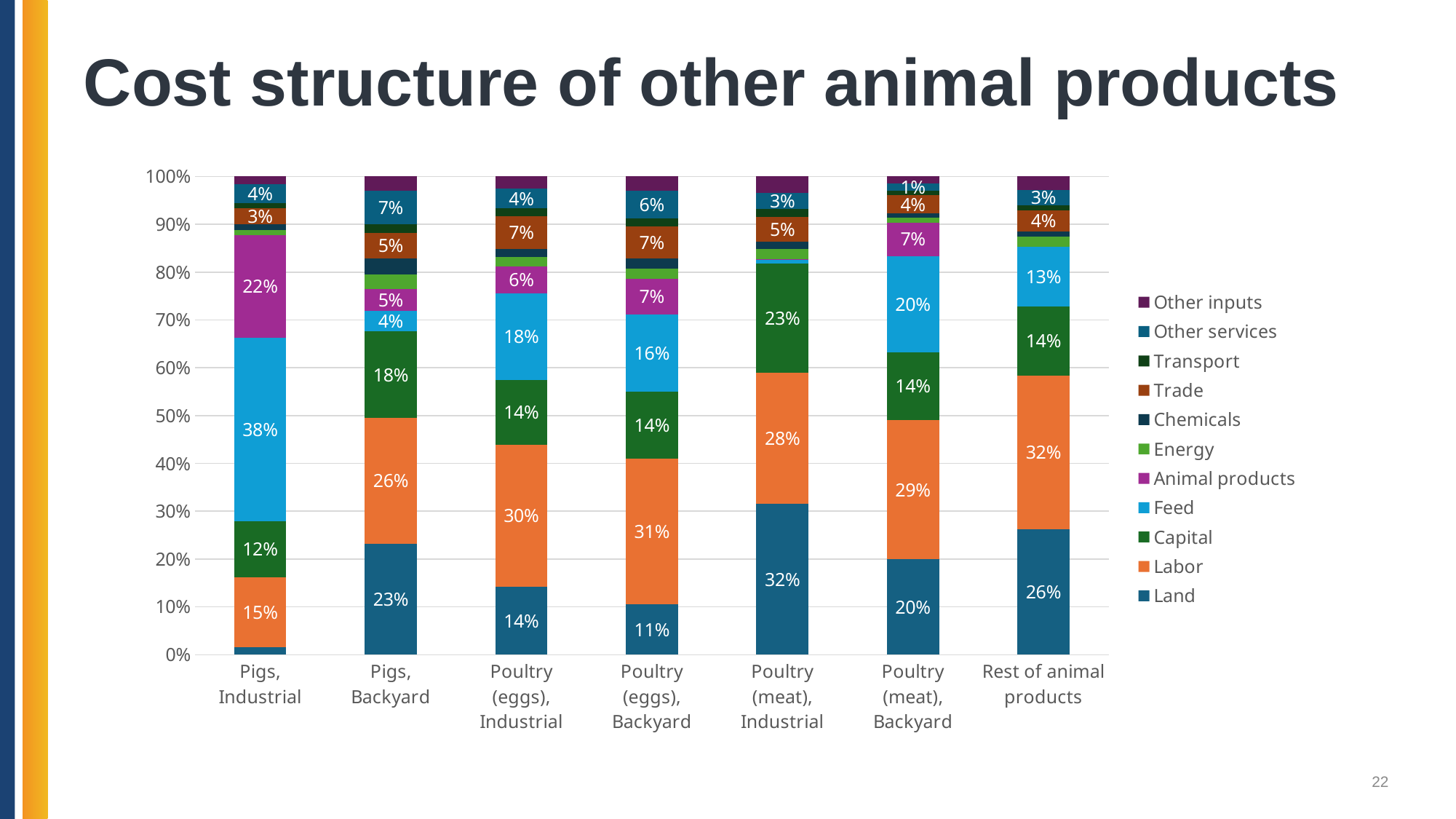
Which category has the highest Feed share? Pigs, Industrial What is the Animal products share for Pigs, Industrial? 22% What is the Other services share for Poultry (meat), Backyard? 1% Which has a larger Capital share: Poultry (meat), Industrial or Pigs, Backyard? Poultry (meat), Industrial How many categories are shown on the x axis? 7 What is the difference in Labor share between Rest of animal products and Pigs, Industrial? 17 percentage points What is the Feed share for Pigs, Industrial? 38% How many series does the legend list? 11 What kind of chart is shown on the slide? Stacked bar chart Is the Land share for Pigs, Industrial greater or less than 10%? less What is the Land share for Poultry (meat), Industrial? 32% Which category has the lowest Land share? Pigs, Industrial